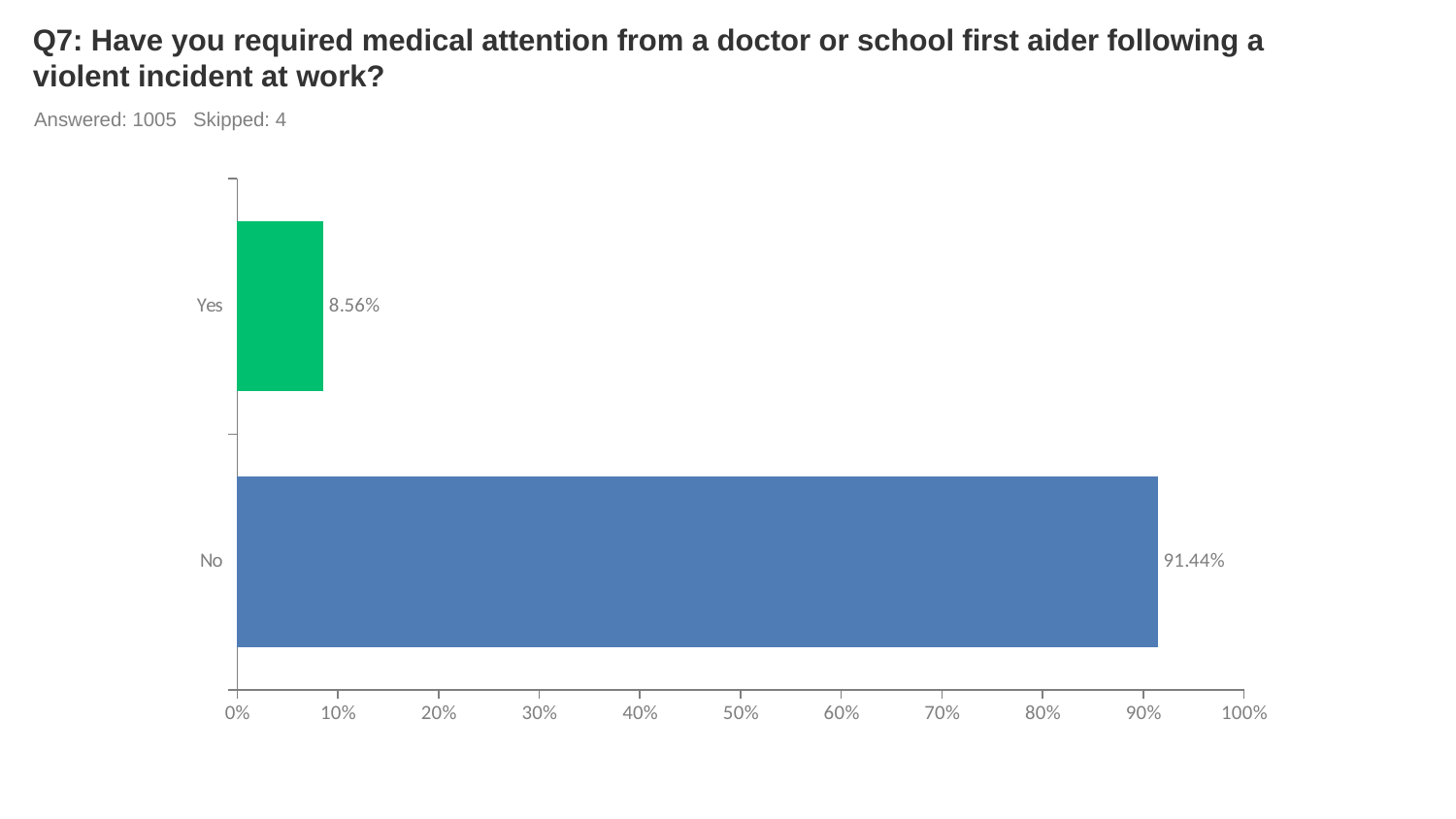
What is the difference in percentage points between the No and Yes responses? 82.88% Which response has the lowest percentage? Yes How many respondents answered this question? 1005 Is the value for Yes greater or less than 10%? less Is the value for No greater or less than 90%? greater What colour is the bar for the Yes response? Green What kind of chart is shown on the slide? Bar chart How many response categories are shown in the chart? 2 Which is larger, the percentage for Yes or the percentage for No? No Which response has the highest percentage? No What percentage of respondents answered Yes? 8.56% What percentage of respondents answered No? 91.44%